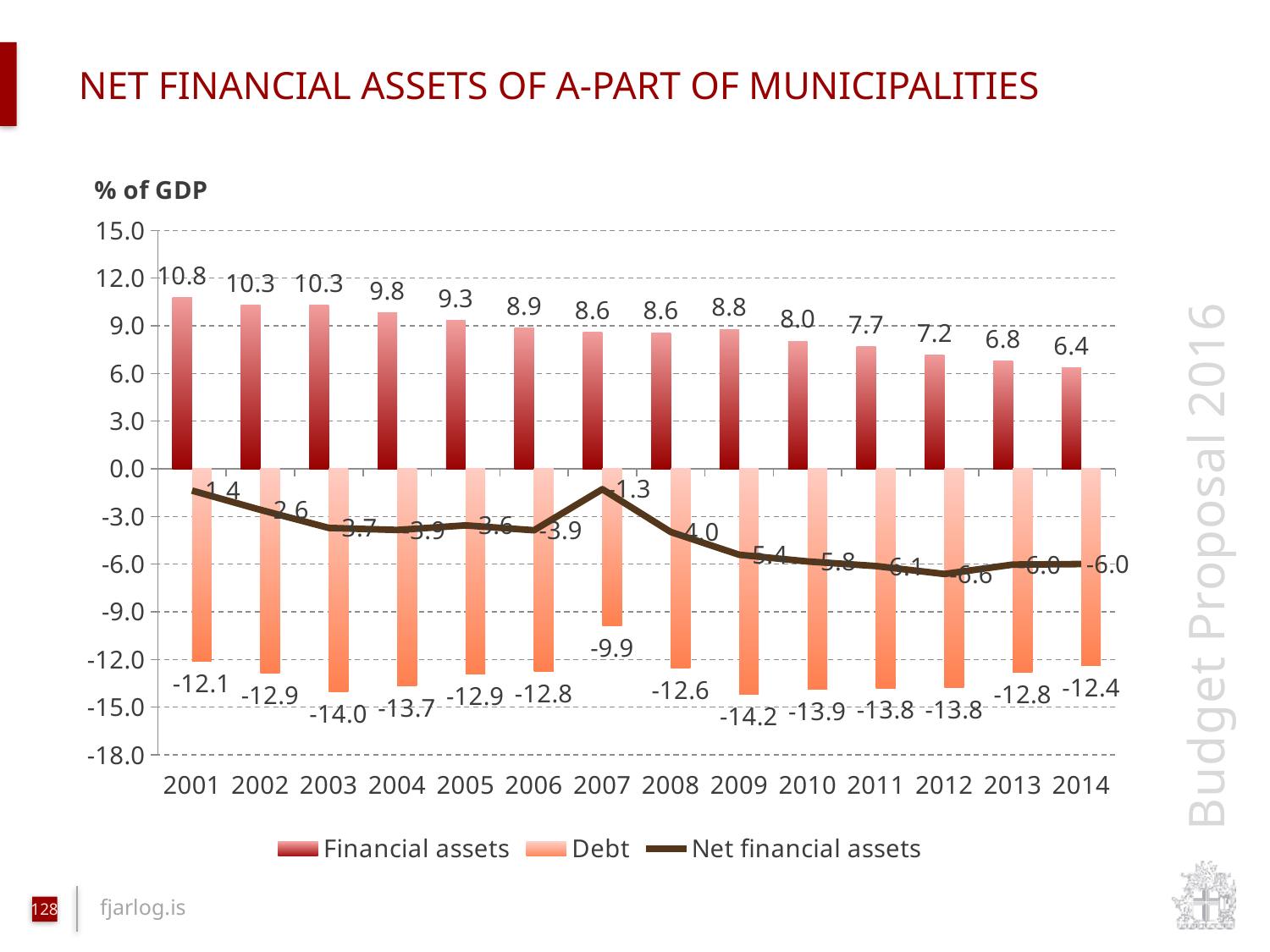
What is the value of Financial assets in 2001? 10.8 What is the value of Net financial assets in 2007? -1.3 In which year are Financial assets lowest? 2014 In which year are Financial assets highest? 2001 What unit is given for the vertical axis? % of GDP How many series does the legend list? 3 What is the difference between Financial assets in 2001 and in 2014? 4.4 What is the value of Debt in 2007? -9.9 What kind of chart is shown on the slide? A combined bar and line chart How many years are shown on the x axis? 14 What is the value of Debt in 2009? -14.2 Which year has higher Financial assets, 2009 or 2010? 2009